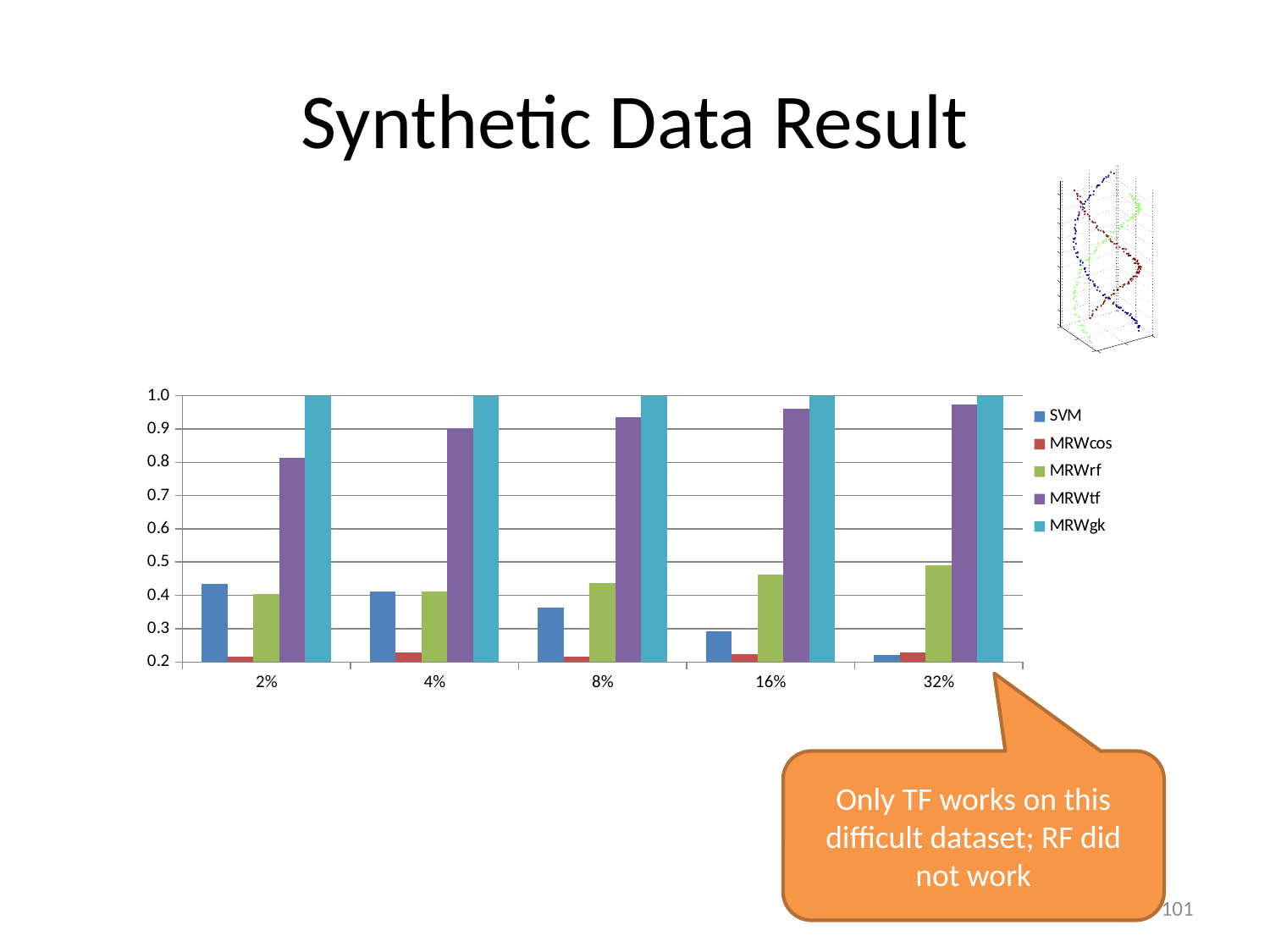
Is the value for MRWtf at 8% greater or less than 0.9? greater What kind of chart is shown on the slide? bar chart How many categories are shown on the x axis? 5 At 32%, which is larger: SVM or MRWrf? MRWrf What is the value for MRWgk at 2%? 1.0 How many series does the legend list? 5 Is the value for SVM at 32% greater or less than 0.3? less Do the values for MRWrf rise or fall as the x axis goes from 2% to 32%? rise Which series has the highest value at 2%? MRWgk Do the values for SVM rise or fall as the x axis goes from 2% to 32%? fall Is the value for SVM at 2% greater or less than 0.4? greater Which series has the lowest value at 2%? MRWcos